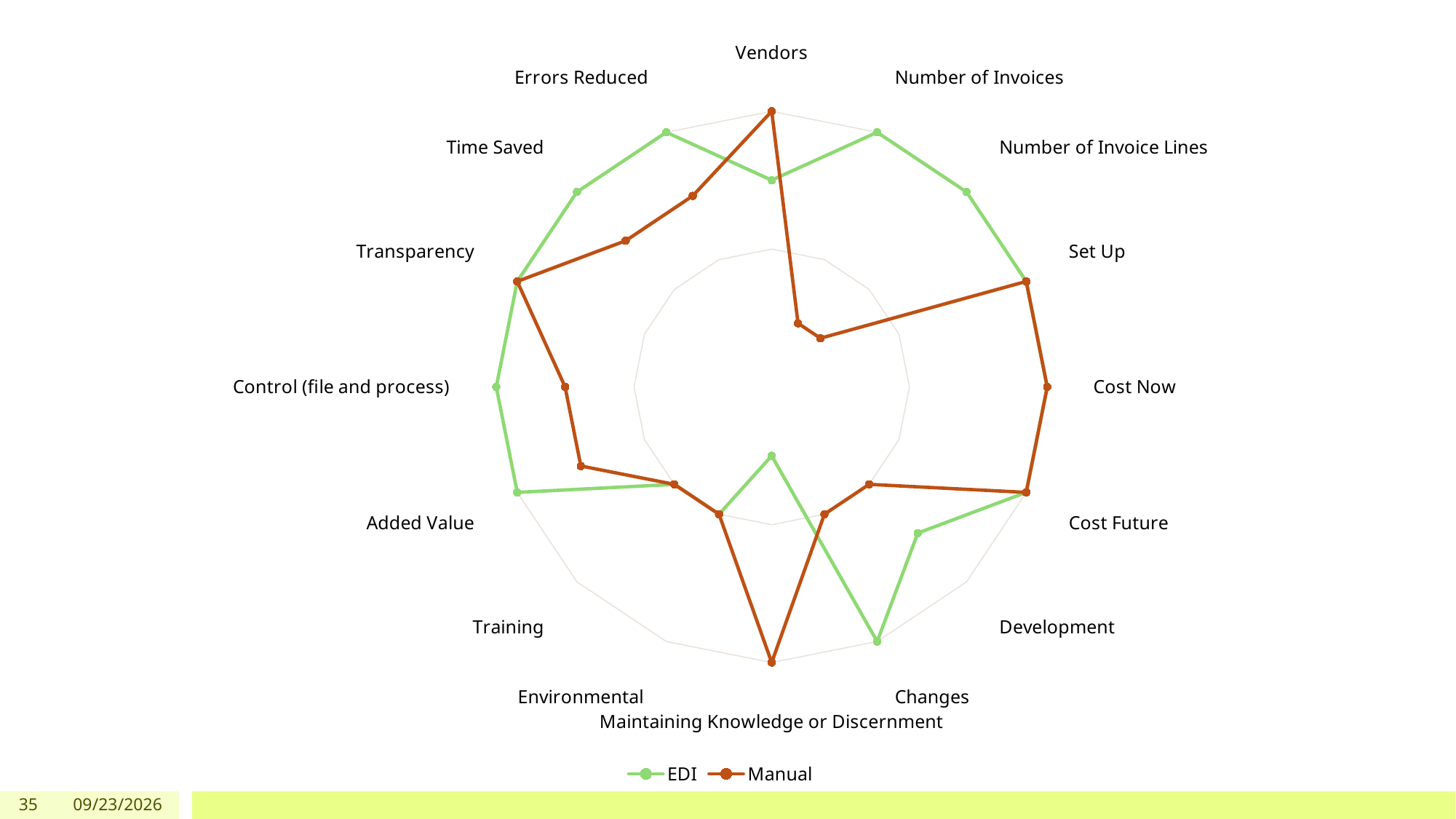
How many series does the legend list? 2 For Maintaining Knowledge or Discernment, which series has the larger value, EDI or Manual? Manual What are the two series named in the legend? EDI and Manual For Changes, which series has the larger value, EDI or Manual? EDI What colour is the line for the EDI series? Green For Cost Now, which series has the larger value, EDI or Manual? Neither; they are equal What kind of chart is shown on the slide? Radar chart How many categories (axes) does the radar chart have? 16